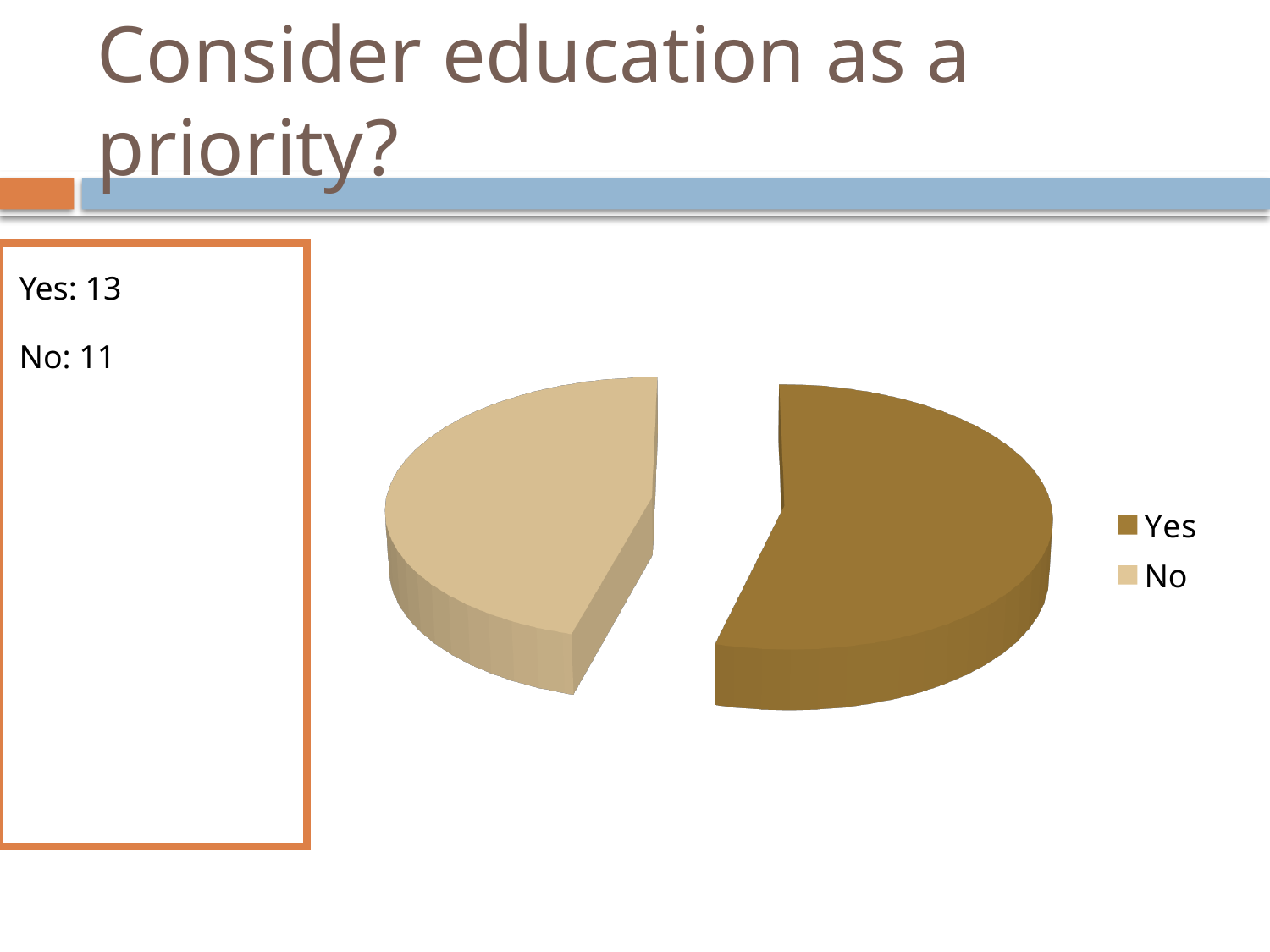
Which legend entry is shown in the darker brown colour? Yes What kind of chart is shown on the slide? pie chart What is the difference between the value for Yes and the value for No? 2 What is the title of the slide containing the chart? Consider education as a priority? What is the value for Yes? 13 What is the value for No? 11 Which category has the largest slice of the pie? Yes How many slices does the pie chart have? 2 How many entries does the legend list? 2 Which is larger, the value for Yes or the value for No? Yes Which category has the smallest slice of the pie? No